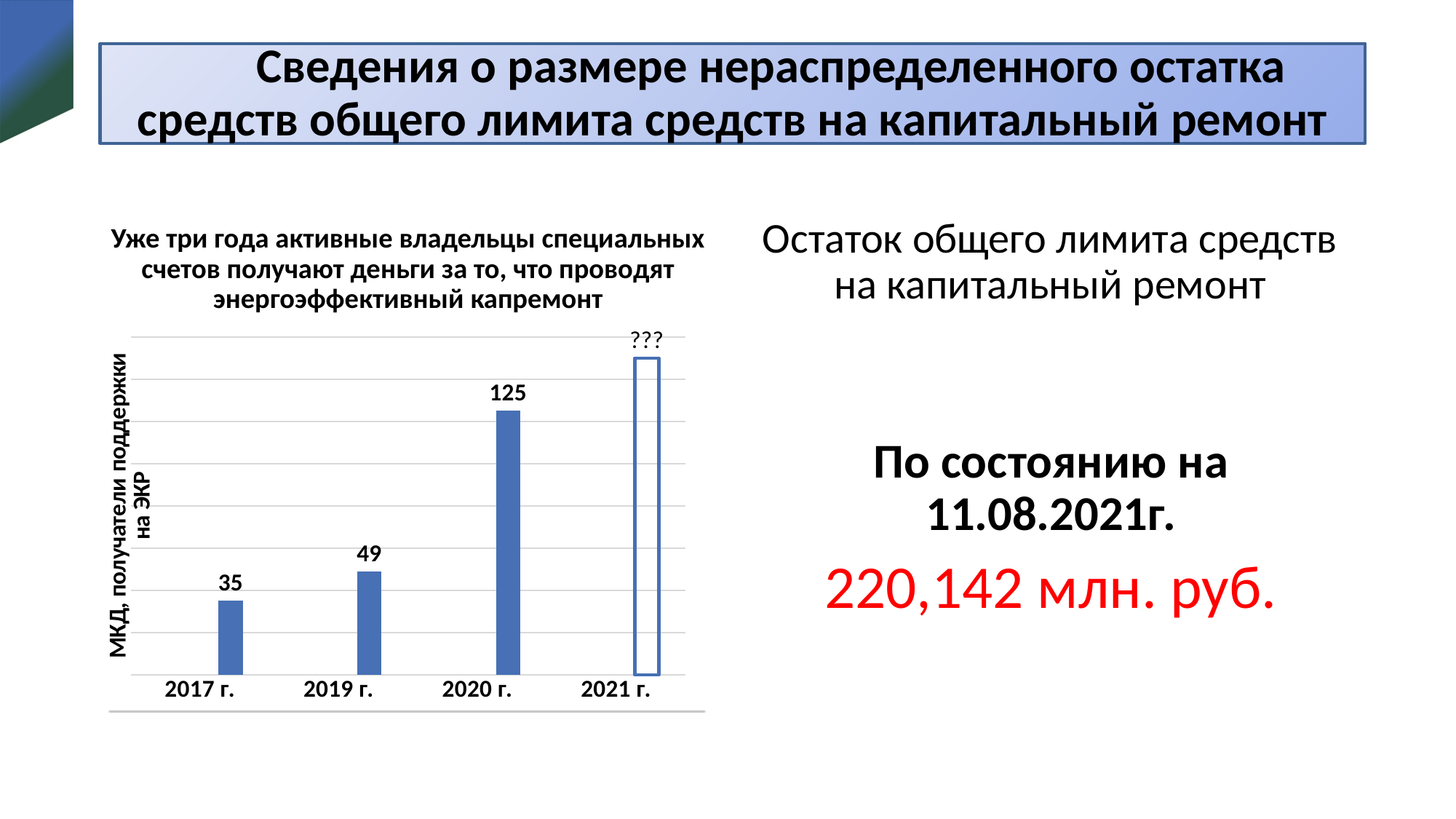
What is the difference between the values for 2020 г. and 2017 г.? 90 What label is shown above the bar for 2021 г.? ??? What is the difference between the values for 2019 г. and 2017 г.? 14 Do the labeled values rise or fall from 2017 г. to 2020 г.? rise Which is larger, the value for 2020 г. or the value for 2019 г.? 2020 г. What kind of chart is shown on the slide? bar chart What is the label of the vertical axis of the chart? МКД, получатели поддержки на ЭКР Which year has the lowest value in the chart? 2017 г. What is the value for 2017 г.? 35 What is the value for 2020 г.? 125 How many years (categories) are shown on the x axis of the chart? 4 What is the value for 2019 г.? 49